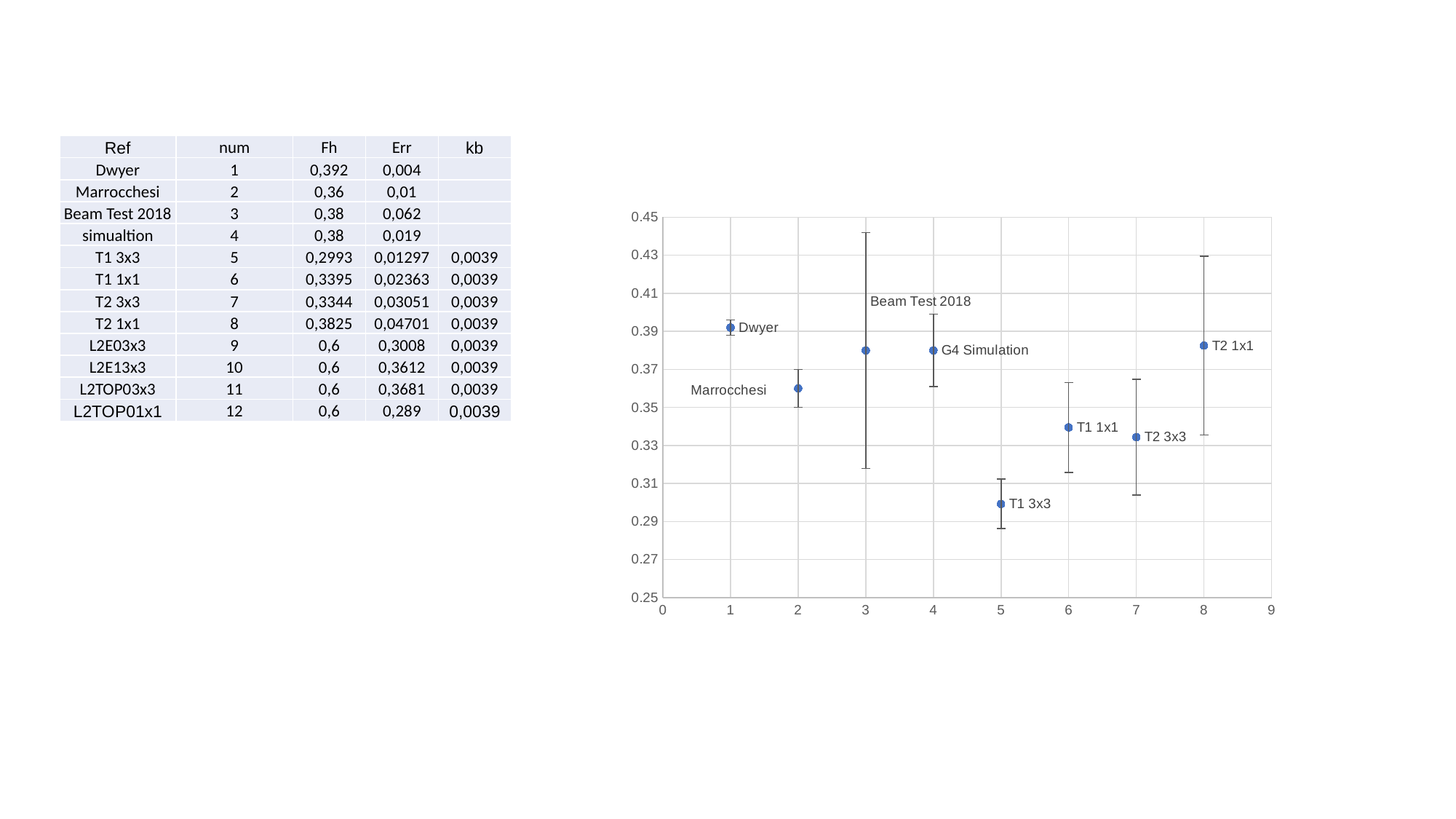
Is the value for Marrocchesi on the chart greater or less than 0.35? greater Is the value for T1 3x3 on the chart greater or less than 0.31? less Which labelled point on the chart has the lowest value? T1 3x3 What kind of chart is shown on the right of the slide? scatter chart Which point is labelled at x = 3 on the chart? Beam Test 2018 Is the value for Dwyer on the chart greater or less than 0.37? greater On the chart, which is larger, the value for Marrocchesi or the value for T1 1x1? Marrocchesi Which point is labelled at x = 4 on the chart? G4 Simulation How many data points are plotted on the chart? 8 Which labelled point on the chart has the highest value? Dwyer On the chart, which is larger, the value for Dwyer or the value for Marrocchesi? Dwyer